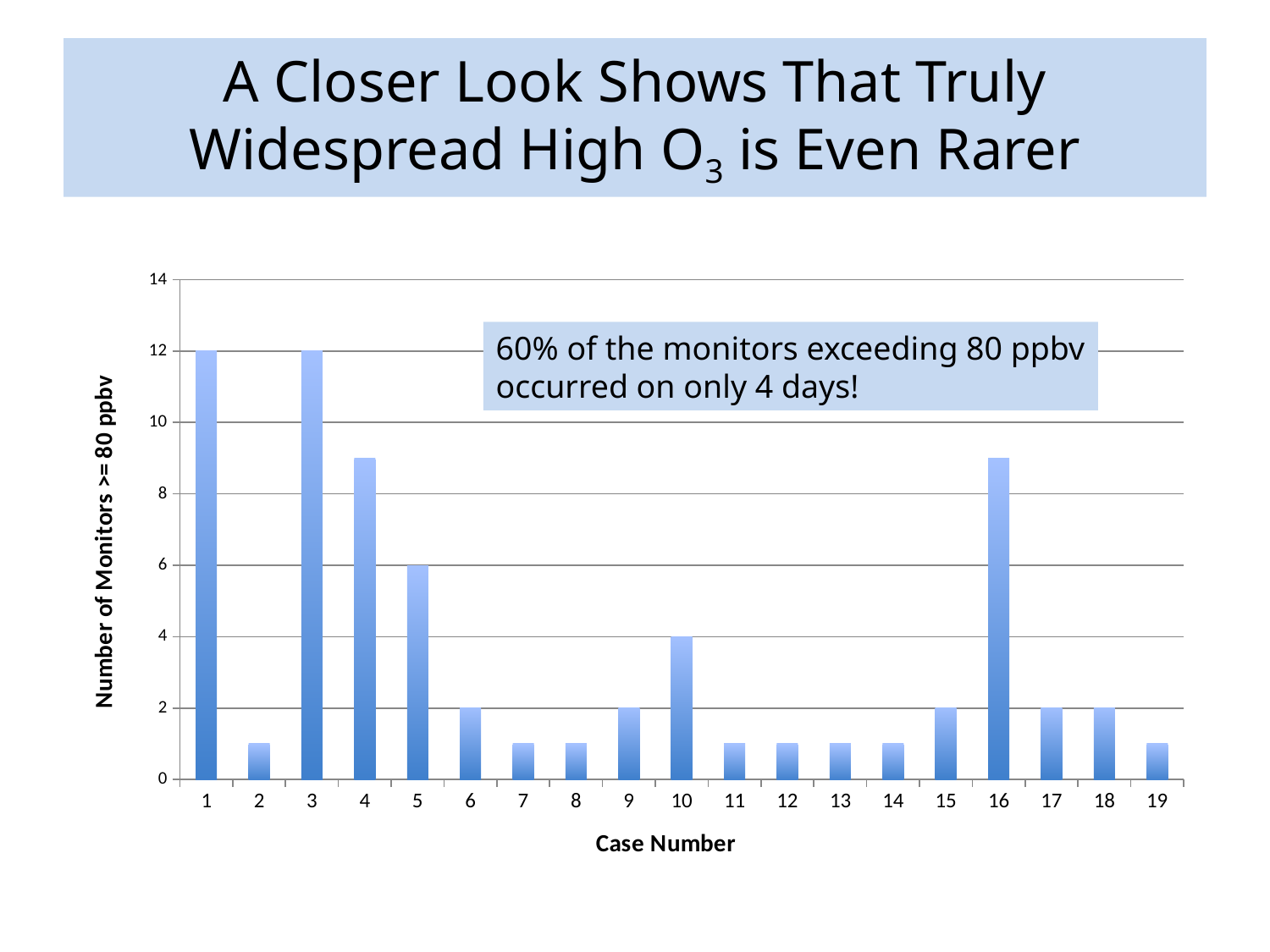
According to the text box on the chart, what share of the monitors exceeding 80 ppbv occurred on only 4 days? 60% What is the number of monitors >= 80 ppbv for case 1? 12 Which has a larger value, case 4 or case 5? case 4 Which two case numbers have the highest number of monitors >= 80 ppbv? 1 and 3 Is the value for case 16 greater or less than 8? greater What is the number of monitors >= 80 ppbv for case 17? 2 How many case numbers are shown on the x axis? 19 What kind of chart is shown on the slide? bar chart What is the number of monitors >= 80 ppbv for case 10? 4 What is the difference between the values for case 1 and case 5? 6 What is the title of the y axis? Number of Monitors >= 80 ppbv What is the number of monitors >= 80 ppbv for case 5? 6